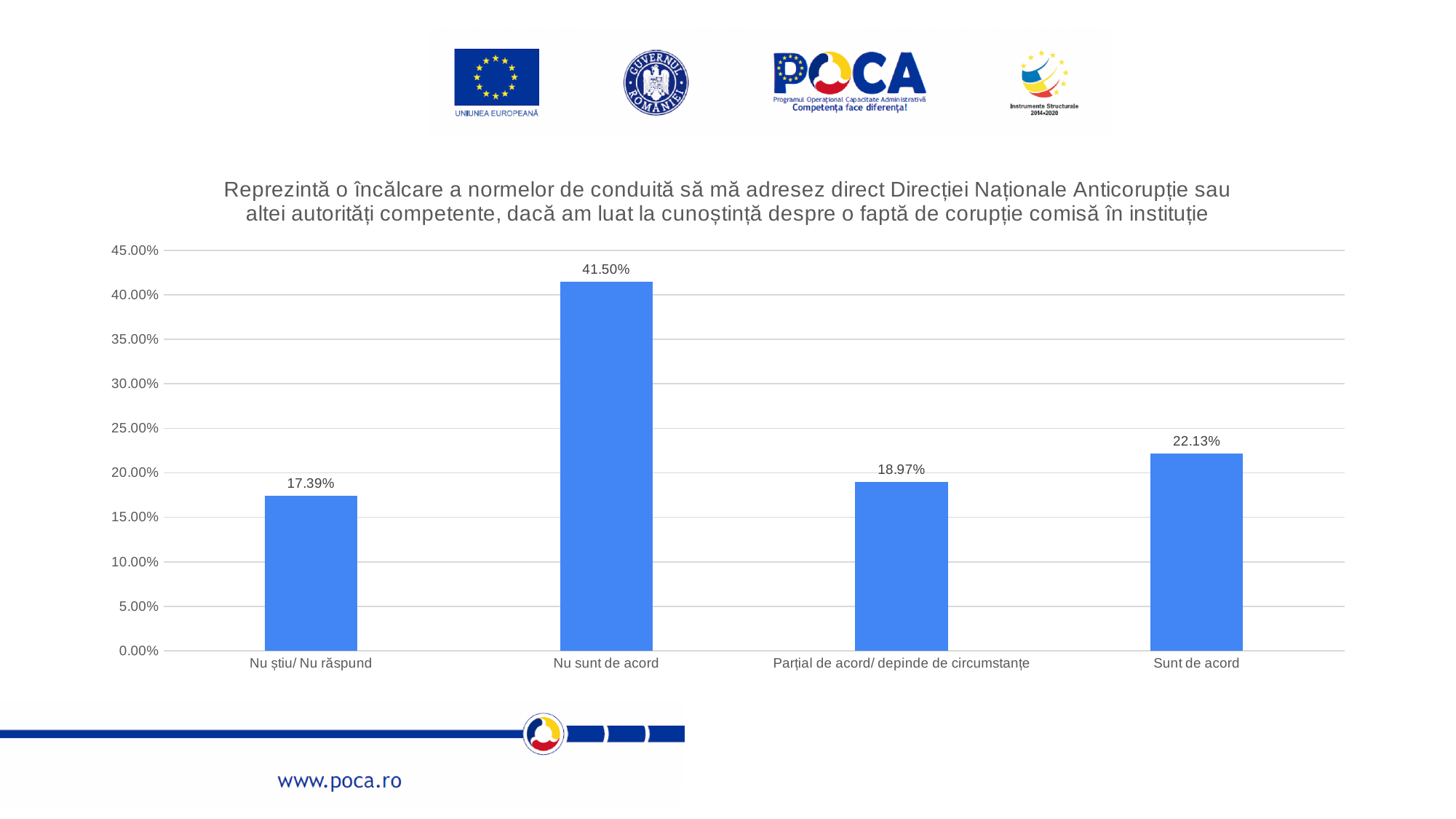
Is the value for "Nu sunt de acord" greater or less than 40.00%? greater Which is larger, the value for "Sunt de acord" or the value for "Parțial de acord/ depinde de circumstanțe"? Sunt de acord What is the value for "Nu sunt de acord"? 41.50% What is the difference between the values for "Nu sunt de acord" and "Sunt de acord"? 19.37% Which category has the highest value? Nu sunt de acord What is the value for "Sunt de acord"? 22.13% What is the value for "Nu știu/ Nu răspund"? 17.39% How many categories are shown on the x axis? 4 What kind of chart is shown on the slide? Bar chart Which category has the lowest value? Nu știu/ Nu răspund What is the highest value shown on the y axis? 45.00% What is the value for "Parțial de acord/ depinde de circumstanțe"? 18.97%